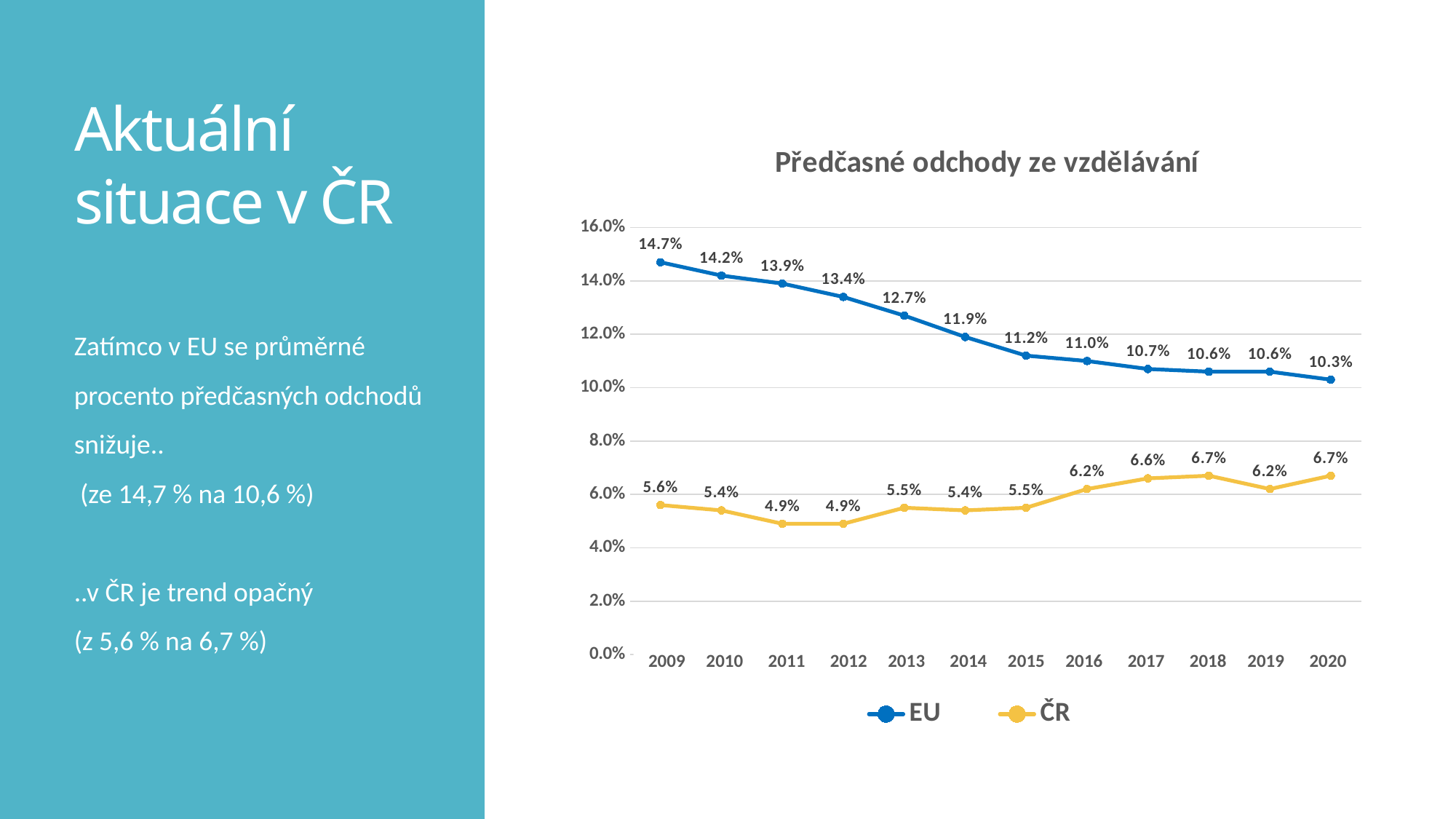
Is the ČR value for 2011 greater or less than 6.0%? less In which year is the EU series lowest? 2020 In which year is the ČR series highest, among the years where it reaches its peak value of 6.7%? 2018 and 2020 What is the ČR value for 2020? 6.7% What is the EU value for 2009? 14.7% What is the EU value for 2015? 11.2% Which is larger in 2020, the EU value or the ČR value? EU How many series does the legend list? 2 How many years are shown on the x axis? 12 Does the EU series rise or fall from 2009 to 2020? fall What kind of chart is shown? line chart What is the difference between the EU and ČR values in 2009? 9.1%